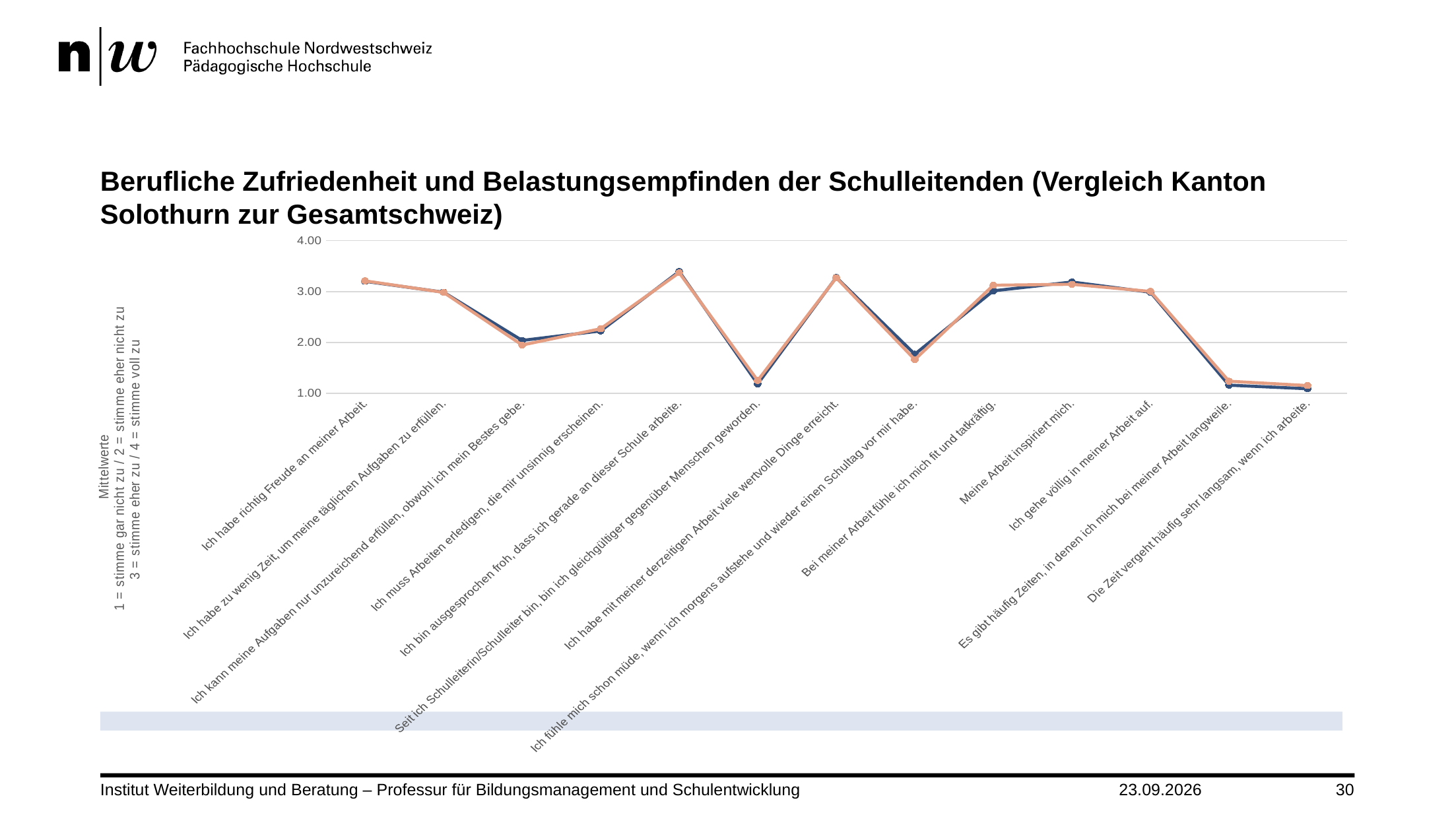
Is the value for "Ich muss Arbeiten erledigen, die mir unsinnig erscheinen." greater or less than 3.00? less Is the value for "Seit ich Schulleiterin/Schulleiter bin, bin ich gleichgültiger gegenüber Menschen geworden." greater or less than 2.00? less Is the value for "Es gibt häufig Zeiten, in denen ich mich bei meiner Arbeit langweile." greater or less than 2.00? less How many statements (categories) are plotted along the x axis of the chart? 13 What kind of chart is shown on the slide? line chart What is the highest tick value shown on the y axis of the chart? 4.00 Which has the higher value: "Ich habe richtig Freude an meiner Arbeit." or "Ich kann meine Aufgaben nur unzureichend erfüllen, obwohl ich mein Bestes gebe."? Ich habe richtig Freude an meiner Arbeit. What is the title of the chart on the slide? Berufliche Zufriedenheit und Belastungsempfinden der Schulleitenden (Vergleich Kanton Solothurn zur Gesamtschweiz) Which has the higher value: "Ich habe mit meiner derzeitigen Arbeit viele wertvolle Dinge erreicht." or "Die Zeit vergeht häufig sehr langsam, wenn ich arbeite."? Ich habe mit meiner derzeitigen Arbeit viele wertvolle Dinge erreicht.